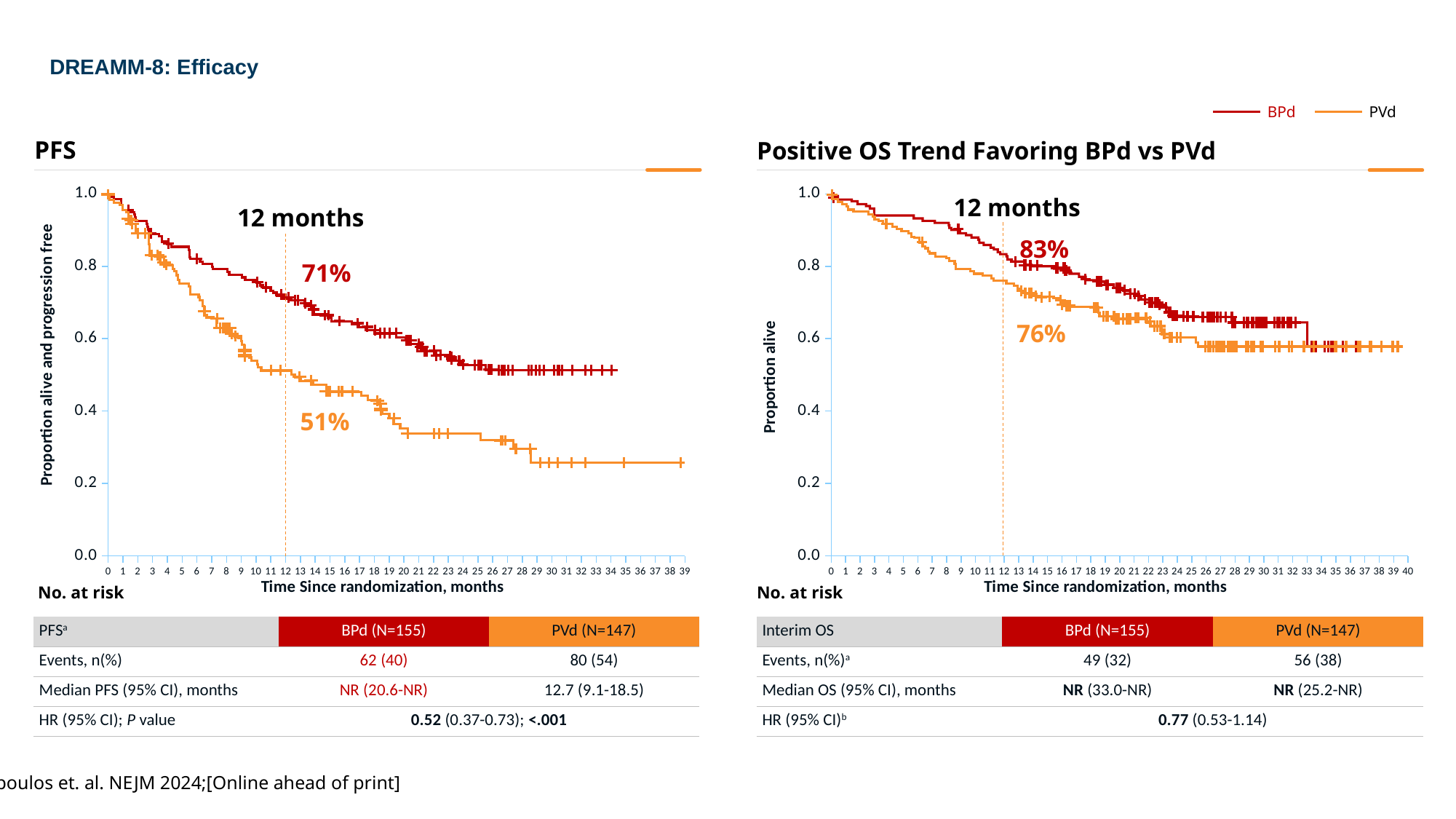
In the PFS chart, which arm has the higher labelled value at 12 months, BPd or PVd? BPd In the 'Positive OS Trend Favoring BPd vs PVd' chart, what is the difference between the BPd and PVd labelled values at 12 months? 7 percentage points In the PFS chart, do the curves rise or fall as time since randomization increases? fall In the 'Positive OS Trend Favoring BPd vs PVd' chart, what is the labelled proportion alive for BPd at 12 months? 83% In the 'Positive OS Trend Favoring BPd vs PVd' chart, what is the labelled proportion alive for PVd at 12 months? 76% In the PFS chart, what is the difference between the BPd and PVd labelled values at 12 months? 20 percentage points How many series does the legend list for the charts on this slide? 2 In the 'Positive OS Trend Favoring BPd vs PVd' chart, is the PVd curve at 12 months greater or less than 0.8? less In the PFS chart, what is the labelled proportion alive and progression free for PVd at 12 months? 51% What kind of chart is the PFS chart? Line chart (Kaplan-Meier curve) In the PFS chart, is the PVd curve at 30 months greater or less than 0.4? less In the PFS chart, what is the labelled proportion alive and progression free for BPd at 12 months? 71%